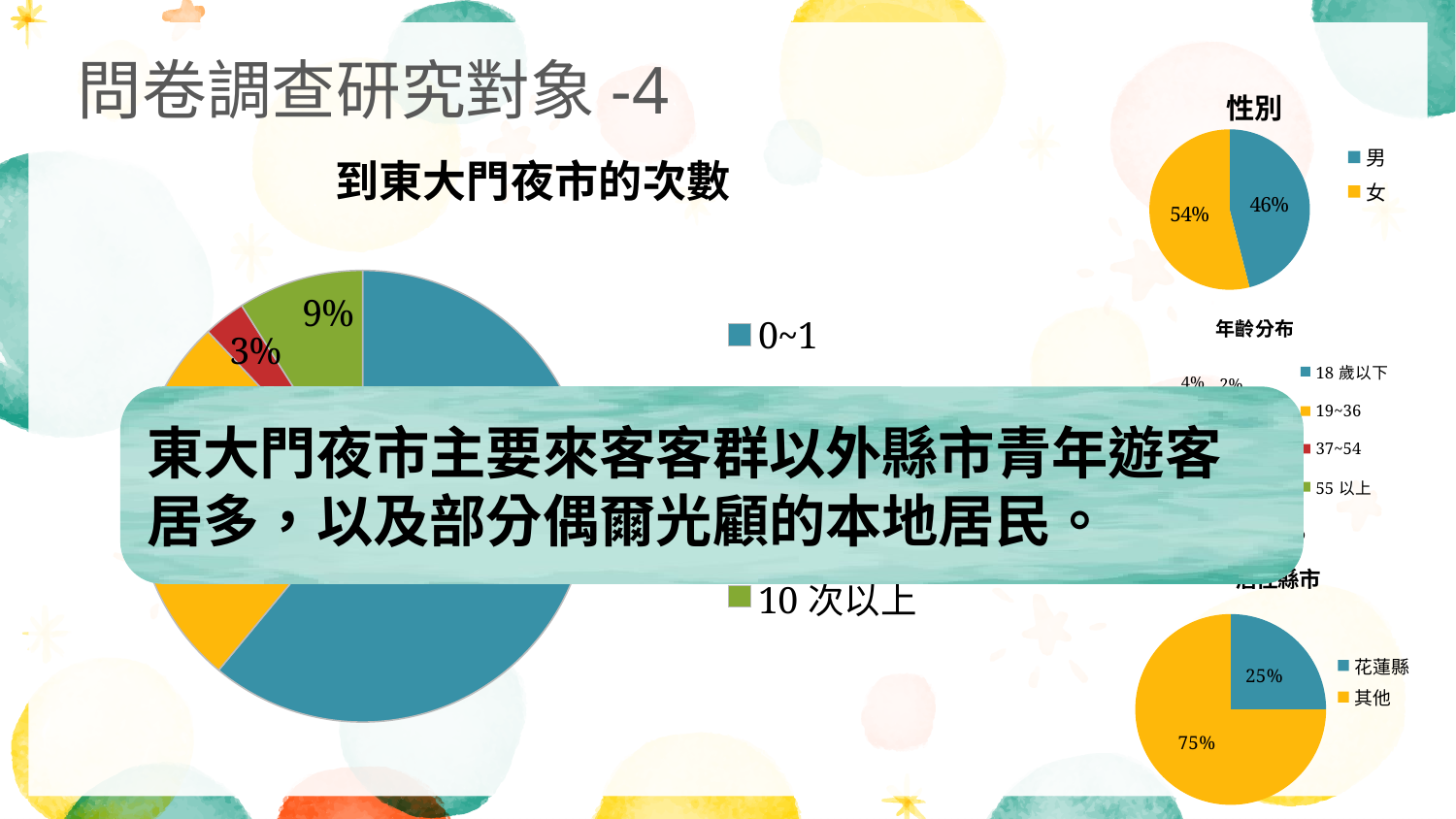
In the bottom-right pie chart (居住縣市), which category is the largest? 其他 In the bottom-right pie chart (居住縣市), what percentage is 花蓮縣? 25% In the 性別 pie chart, what percentage is 女? 54% In the 性別 pie chart, which category has the larger share, 男 or 女? 女 In the bottom-right pie chart (居住縣市), what percentage is 其他? 75% In the 性別 pie chart, what is the difference between the 女 share and the 男 share? 8% In the 到東大門夜市的次數 pie chart, what percentage is 10 次以上? 9% In the bottom-right pie chart (居住縣市), what is the difference between 其他 and 花蓮縣? 50% In the 性別 pie chart, what percentage is 男? 46% How many categories does the legend of the 年齡分布 chart list? 4 What kind of chart is the 性別 chart? pie chart In the 到東大門夜市的次數 pie chart, which category has the largest slice? 0~1